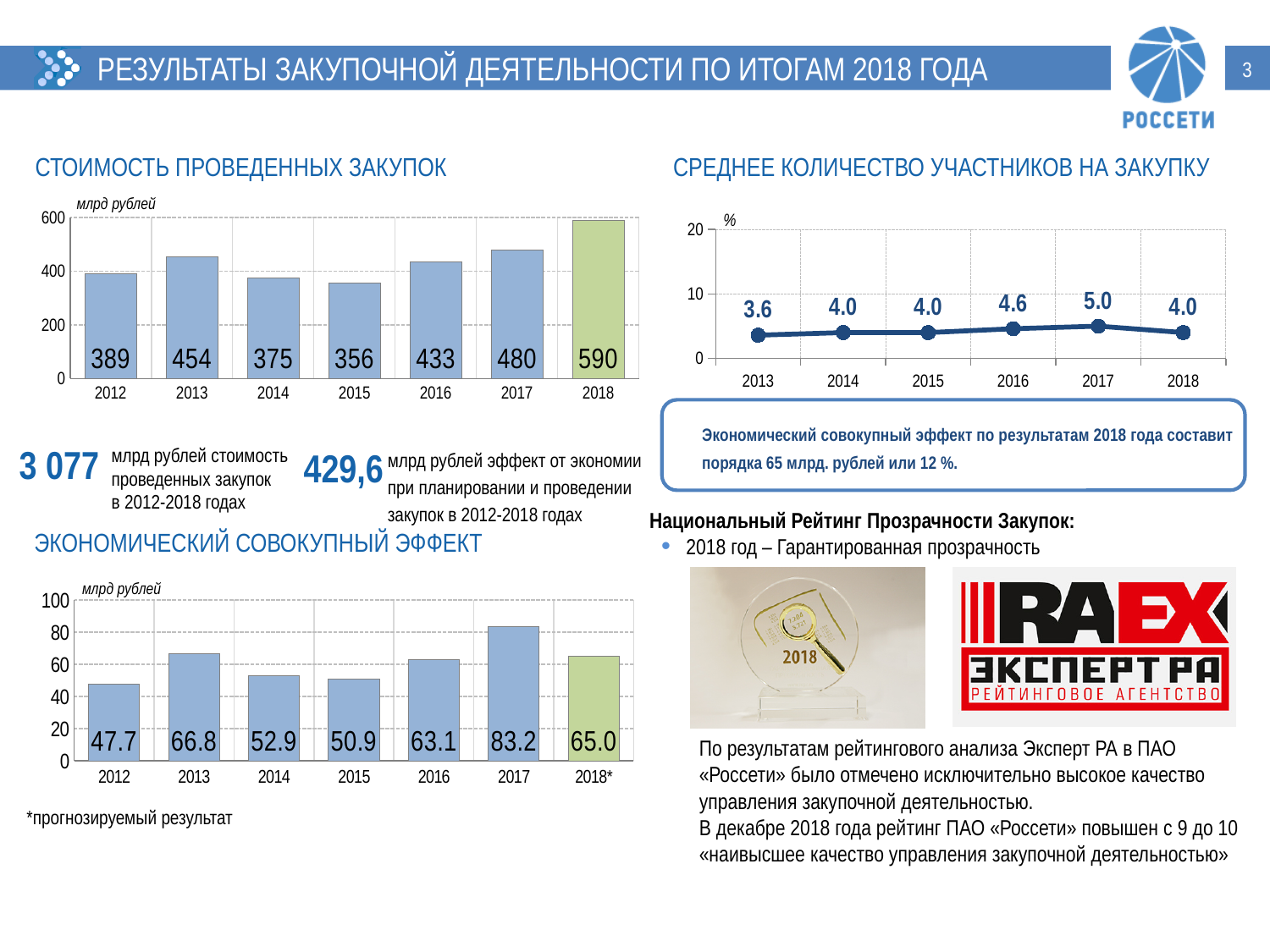
In the chart 'СТОИМОСТЬ ПРОВЕДЕННЫХ ЗАКУПОК', which year has the highest value? 2018 In the chart 'СТОИМОСТЬ ПРОВЕДЕННЫХ ЗАКУПОК', which year has the lowest value? 2015 In the chart 'ЭКОНОМИЧЕСКИЙ СОВОКУПНЫЙ ЭФФЕКТ', which year has the highest value? 2017 In the chart 'ЭКОНОМИЧЕСКИЙ СОВОКУПНЫЙ ЭФФЕКТ', which is larger, the value for 2013 or the value for 2016? 2013 In the chart 'СТОИМОСТЬ ПРОВЕДЕННЫХ ЗАКУПОК', what is the value for 2016? 433 What kind of chart is 'ЭКОНОМИЧЕСКИЙ СОВОКУПНЫЙ ЭФФЕКТ'? bar chart In the chart 'СТОИМОСТЬ ПРОВЕДЕННЫХ ЗАКУПОК', how many years are shown on the x axis? 7 In the chart 'СРЕДНЕЕ КОЛИЧЕСТВО УЧАСТНИКОВ НА ЗАКУПКУ', which year has the highest value? 2017 In the chart 'СТОИМОСТЬ ПРОВЕДЕННЫХ ЗАКУПОК', what is the difference between the values for 2018 and 2017? 110 What kind of chart is 'СРЕДНЕЕ КОЛИЧЕСТВО УЧАСТНИКОВ НА ЗАКУПКУ'? line chart In the chart 'СРЕДНЕЕ КОЛИЧЕСТВО УЧАСТНИКОВ НА ЗАКУПКУ', what is the value for 2016? 4.6 In the chart 'ЭКОНОМИЧЕСКИЙ СОВОКУПНЫЙ ЭФФЕКТ', what is the value for 2014? 52.9